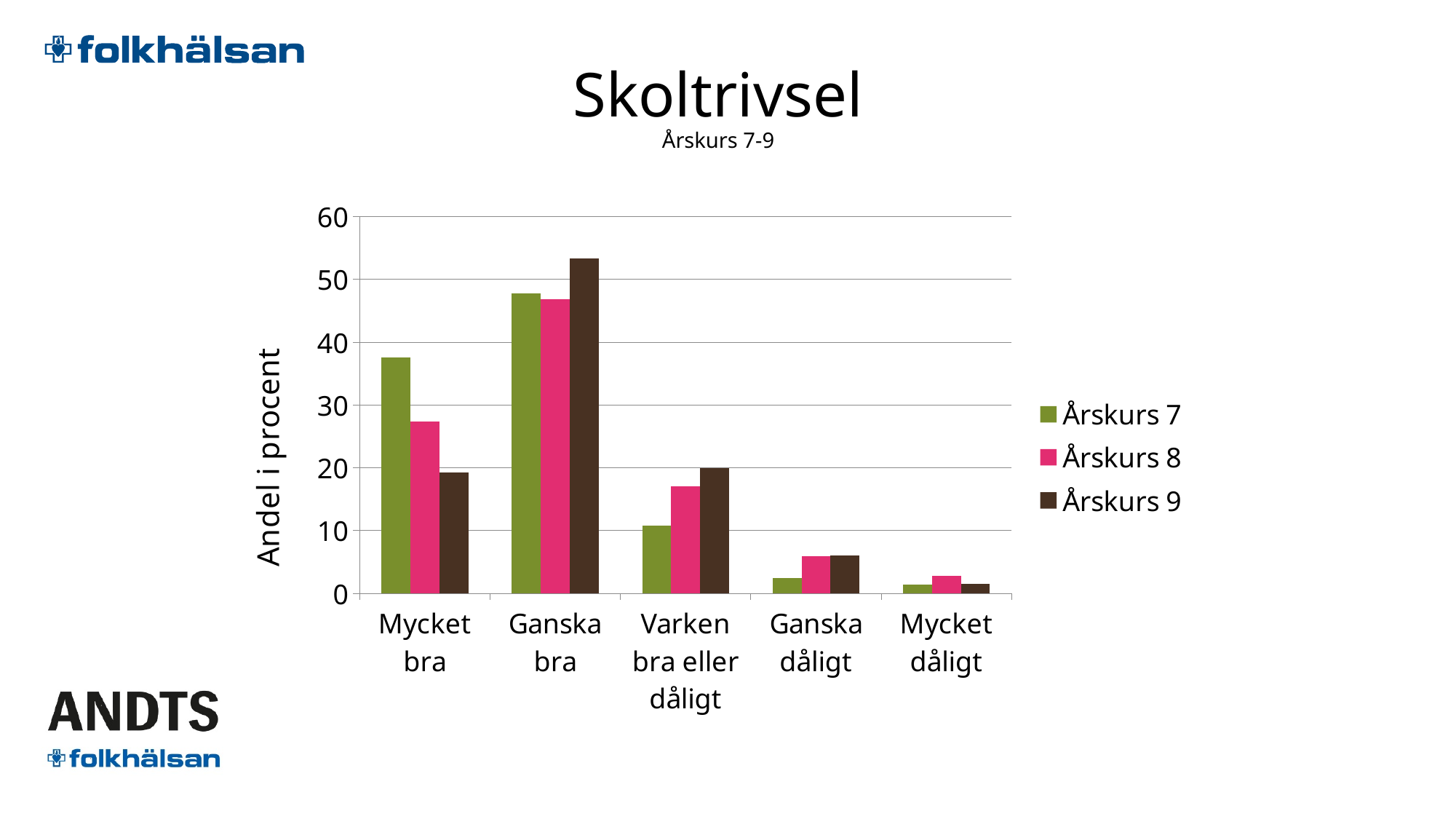
What kind of chart is shown on the slide? bar chart Which category has the highest value for Årskurs 7? Ganska bra What is the title of the vertical axis? Andel i procent For the category Varken bra eller dåligt, which is larger: Årskurs 7 or Årskurs 9? Årskurs 9 Is the value for Årskurs 9 in the category Ganska bra greater or less than 50? greater How many categories are shown on the x axis? 5 For the category Mycket bra, which is larger: Årskurs 7 or Årskurs 9? Årskurs 7 Is the value for Årskurs 7 in the category Mycket bra greater or less than 30? greater Which category has the lowest value for Årskurs 7? Mycket dåligt Which category has the highest value for Årskurs 9? Ganska bra Is the value for Årskurs 8 in the category Varken bra eller dåligt greater or less than 20? less How many series does the legend list? 3